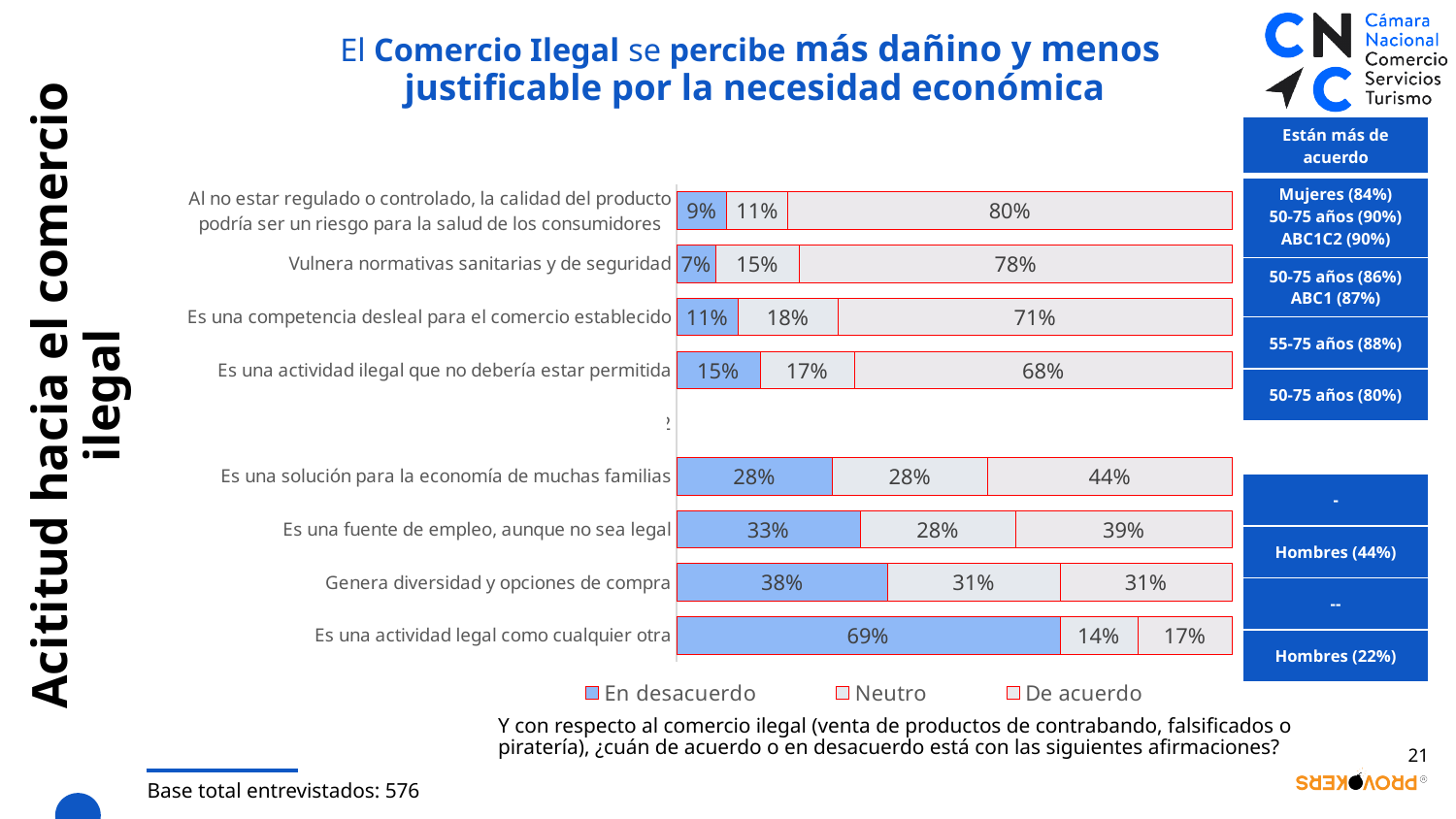
How many series does the legend list? 3 What is the 'Neutro' value for 'Es una competencia desleal para el comercio establecido'? 18% What kind of chart is shown on the slide? Stacked bar chart What is the 'En desacuerdo' value for 'Genera diversidad y opciones de compra'? 38% What is the total of the three segments for 'Es una solución para la economía de muchas familias'? 100% Which statement has the highest 'De acuerdo' percentage? Al no estar regulado o controlado, la calidad del producto podría ser un riesgo para la salud de los consumidores Which is larger: the 'En desacuerdo' value for 'Es una fuente de empleo, aunque no sea legal' or for 'Es una solución para la economía de muchas familias'? Es una fuente de empleo, aunque no sea legal What is the difference between the 'De acuerdo' values for 'Vulnera normativas sanitarias y de seguridad' and 'Es una actividad ilegal que no debería estar permitida'? 10% What is the base total of respondents stated on the slide? 576 What percentage of respondents are 'De acuerdo' with 'Es una actividad legal como cualquier otra'? 17% Which legend entry is shown in blue? En desacuerdo Which statement has the lowest 'En desacuerdo' percentage? Vulnera normativas sanitarias y de seguridad